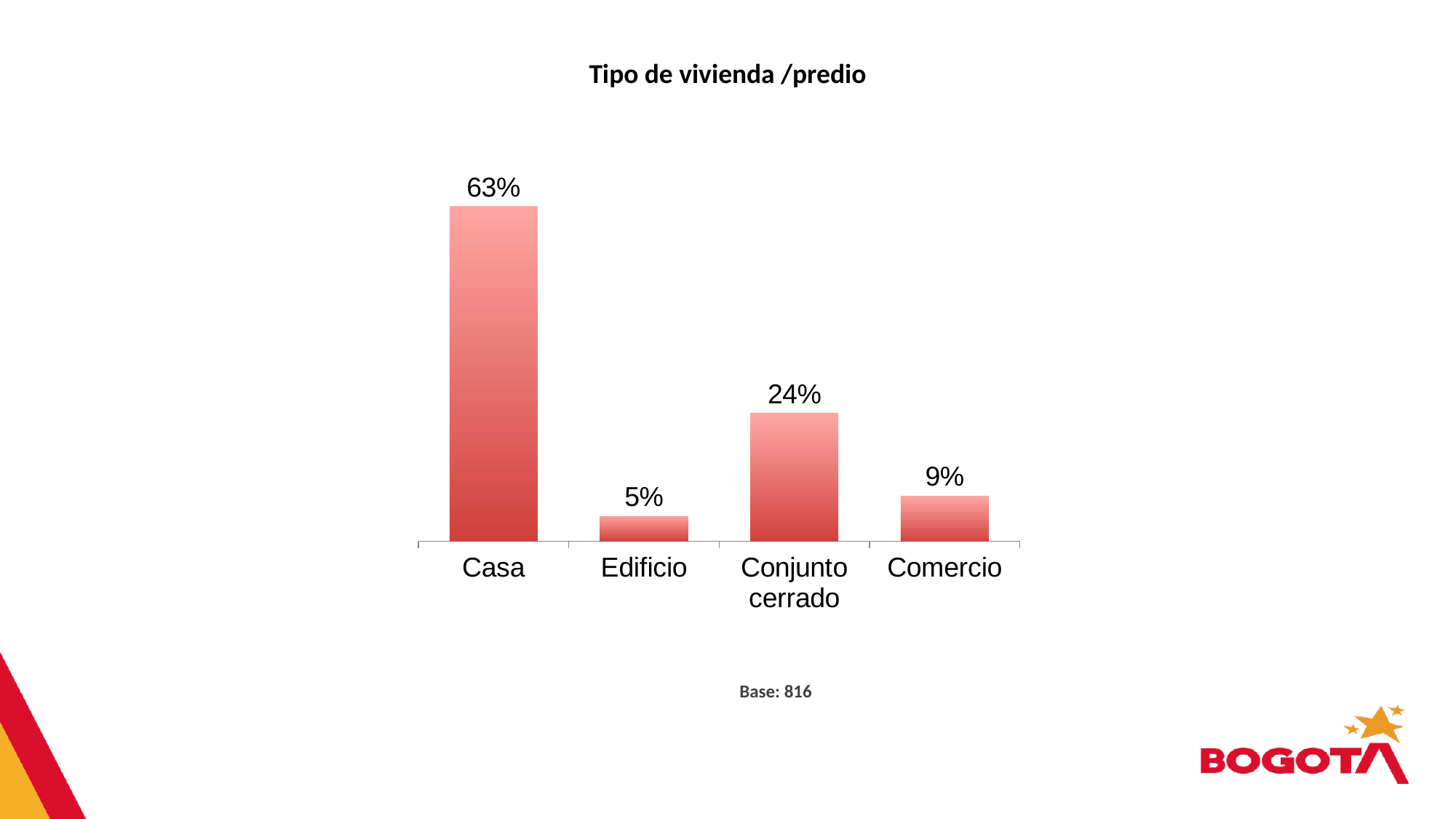
What is the difference between the values for Casa and Conjunto cerrado? 39% What kind of chart is shown on the slide? Bar chart Which category has the lowest value? Edificio What is the value for Casa? 63% What is the difference between the values for Comercio and Edificio? 4% What is the value for Edificio? 5% Which category has the highest value? Casa What is the title of the chart? Tipo de vivienda /predio Which is larger, the value for Conjunto cerrado or the value for Comercio? Conjunto cerrado What is the value for Conjunto cerrado? 24% What is the value for Comercio? 9% How many categories are shown in the chart? 4